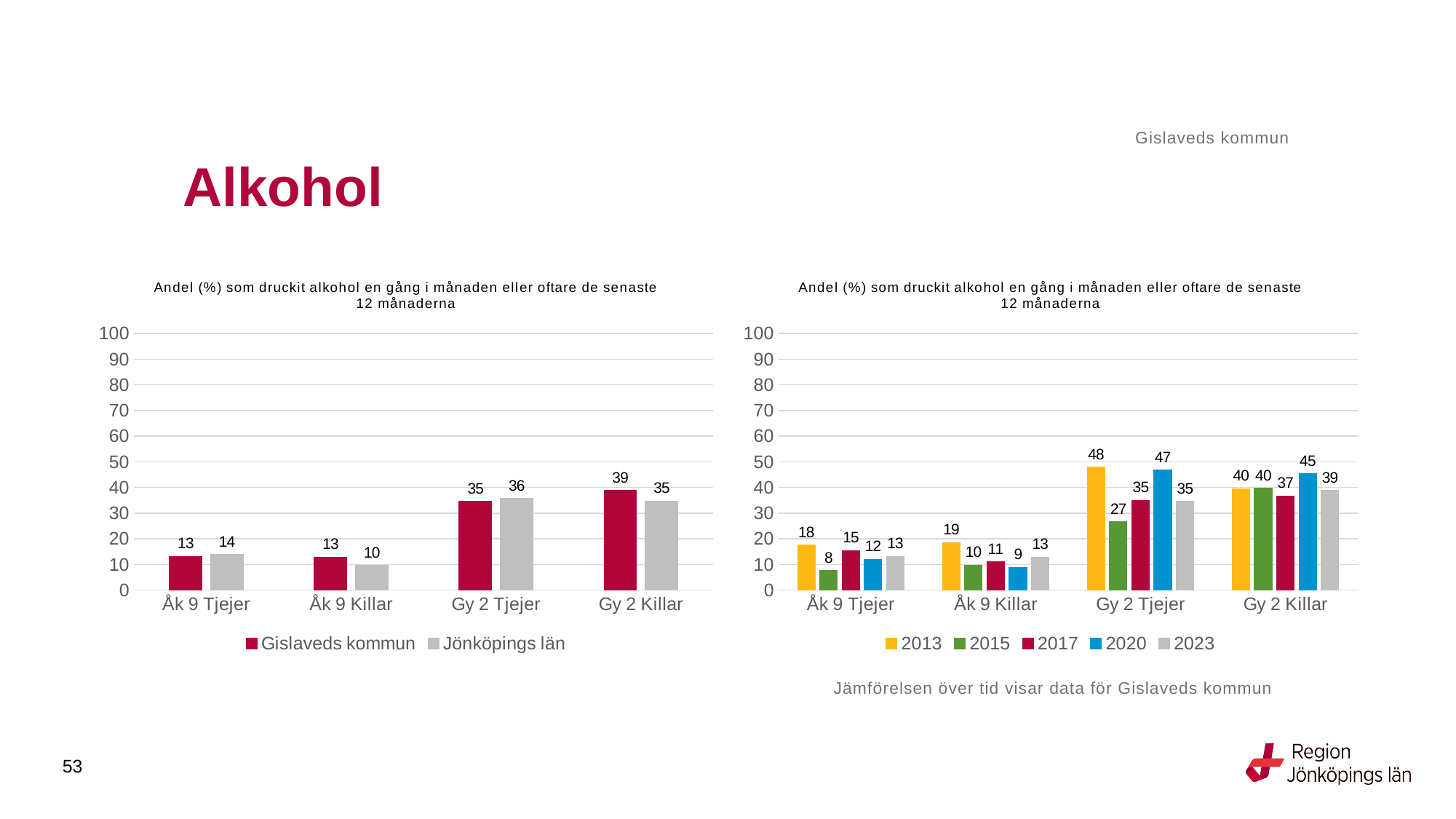
In the left chart, which category has the highest value for Gislaveds kommun? Gy 2 Killar In the right chart, how many series does the legend list? 5 In the left chart, how many series does the legend list? 2 In the left chart, what is the value for Jönköpings län for Åk 9 Killar? 10 In the left chart, what is the value for Gislaveds kommun for Gy 2 Killar? 39 What kind of chart is the right chart? Bar chart In the right chart, which is larger for Gy 2 Killar: 2020 or 2023? 2020 In the right chart, which year has the lowest value for Gy 2 Tjejer? 2015 In the right chart, what is the value for 2013 for Gy 2 Tjejer? 48 In the right chart, what is the difference between 2013 and 2023 for Gy 2 Tjejer? 13 In the left chart, what is the difference between Gislaveds kommun and Jönköpings län for Gy 2 Killar? 4 In the right chart, what is the value for 2015 for Åk 9 Tjejer? 8